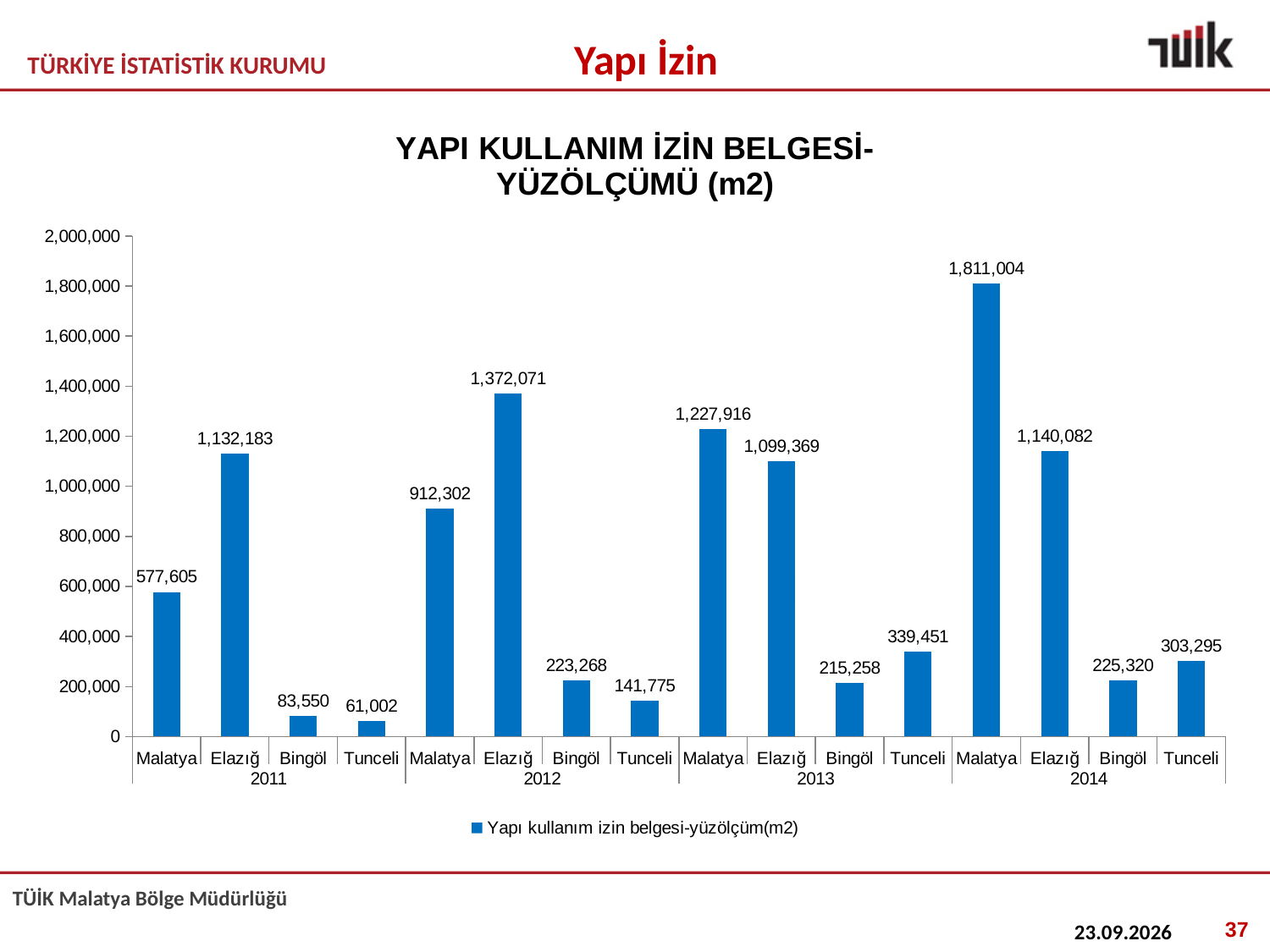
How many bars are plotted on the chart? 16 What is the value for Malatya in 2014? 1,811,004 How many series does the legend list? 1 What is the value for Tunceli in 2011? 61,002 What is the difference between the values for Tunceli and Bingöl in 2013? 124,193 Which bar has the lowest value on the chart? Tunceli 2011 What is the difference between the values for Malatya and Elazığ in 2014? 670,922 Do the values for Malatya rise or fall from 2011 to 2014? Rise What kind of chart is shown on the slide? Bar chart What is the value for Elazığ in 2012? 1,372,071 Which bar has the highest value on the chart? Malatya 2014 Which is larger in 2013, Malatya or Elazığ? Malatya